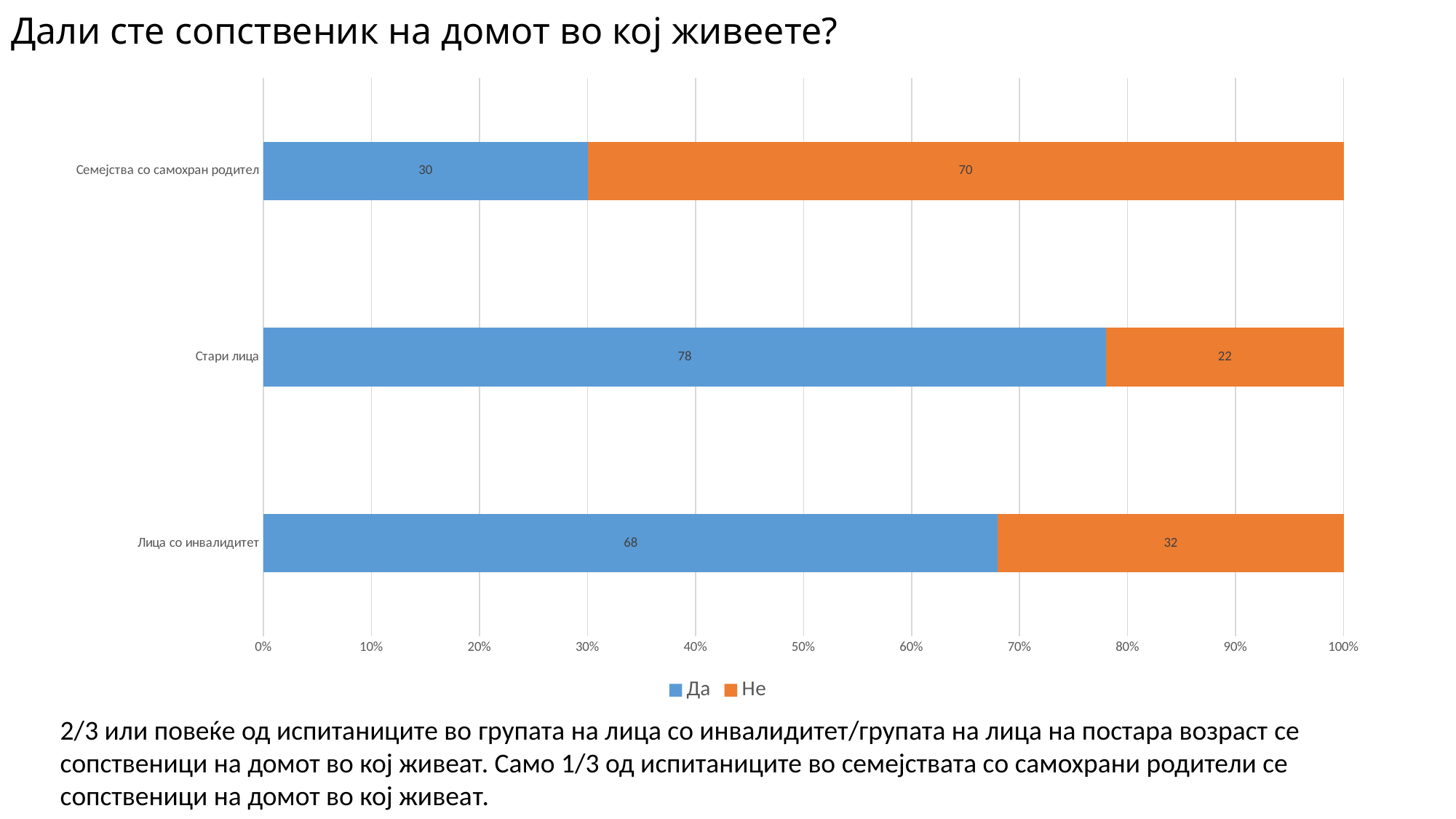
What is the title of the chart? Дали сте сопственик на домот во кој живеете? Which category has the highest value for "Да"? Стари лица Which category has the lowest value for "Не"? Стари лица What is the value for "Не" for "Семејства со самохран родител"? 70 What is the total of the stacked bar for "Семејства со самохран родител"? 100 How many series does the legend list? 2 What is the value for "Да" for "Стари лица"? 78 What is the value for "Да" for "Лица со инвалидитет"? 68 What kind of chart is shown on the slide? Stacked bar chart What is the difference between the "Да" values for "Стари лица" and "Лица со инвалидитет"? 10 How many categories are shown on the chart? 3 Which is larger: the "Не" value for "Лица со инвалидитет" or the "Не" value for "Стари лица"? Лица со инвалидитет